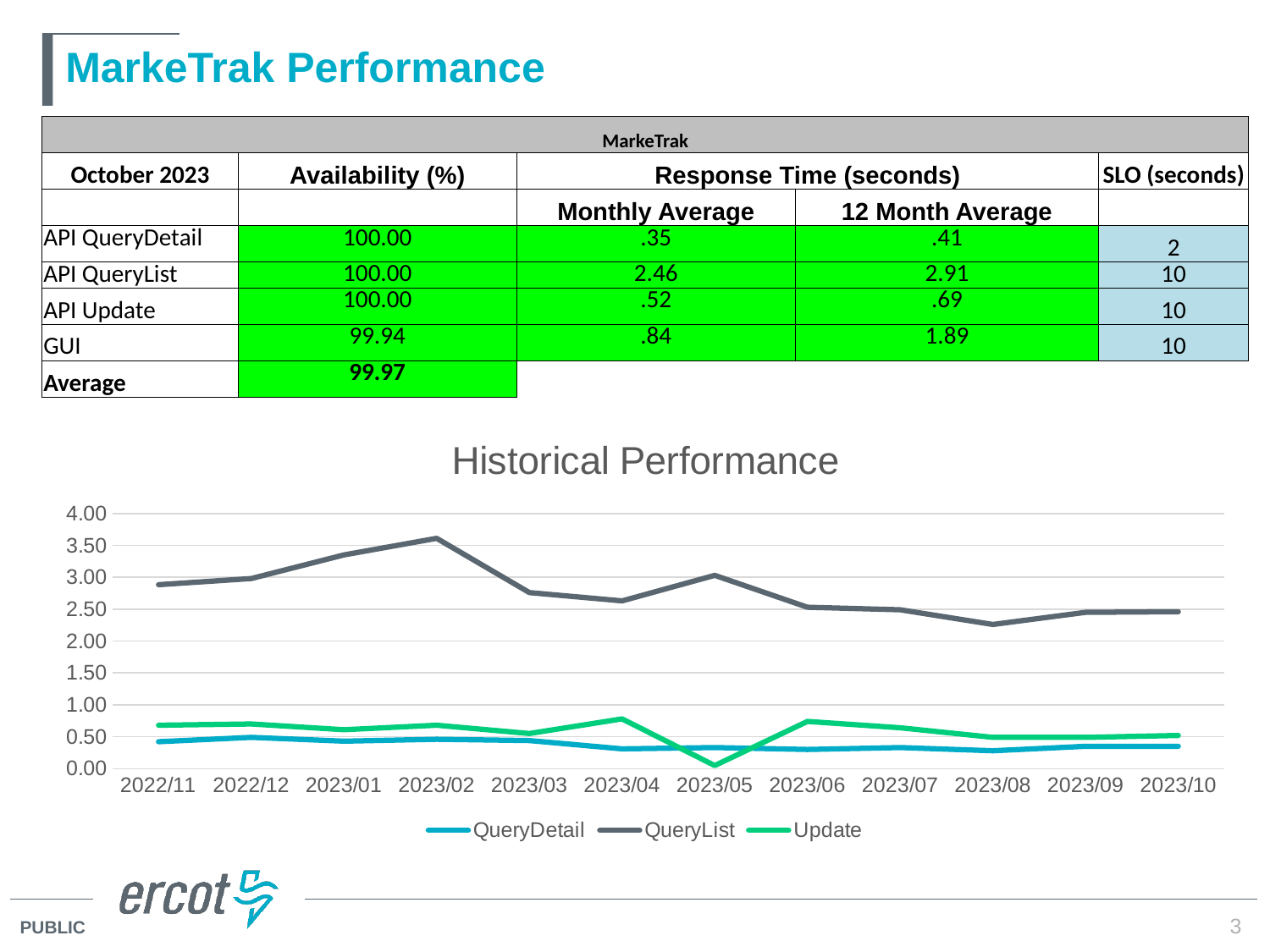
In the Historical Performance chart, does the QueryList series rise or fall from 2023/02 to 2023/08? fall In the Historical Performance chart, which series has the higher value in 2023/06, Update or QueryDetail? Update In the Historical Performance chart, is the QueryList value for 2023/02 greater or less than 3.00? greater What is the title of the line chart on the slide? Historical Performance In the Historical Performance chart, is the QueryList value for 2023/08 greater or less than 2.50? less In the Historical Performance chart, in which month does the QueryList series reach its highest value? 2023/02 In the Historical Performance chart, is the QueryDetail value for 2023/10 greater or less than 0.50? less How many months are shown on the x axis of the Historical Performance chart? 12 What kind of chart is the Historical Performance chart? line chart How many series does the legend of the Historical Performance chart list? 3 In the Historical Performance chart, in which month does the Update series reach its lowest value? 2023/05